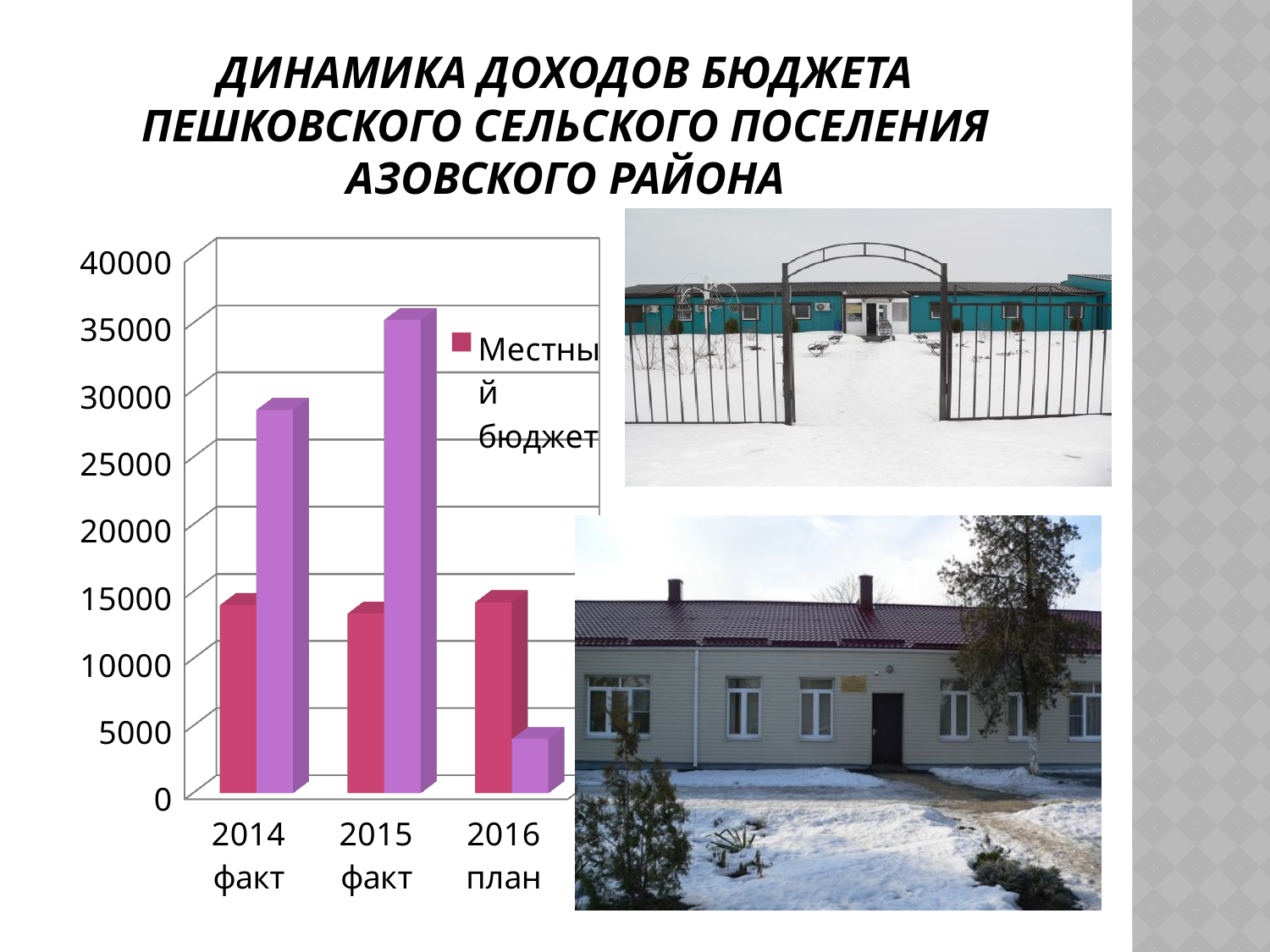
Is the value for Местный бюджет in 2016 план greater or less than 10000? greater Is the value of the purple bar for 2015 факт greater or less than 30000? greater Is the value for Местный бюджет in 2015 факт greater or less than 20000? less For which category is the purple bar the highest? 2015 факт Which series name is readable in the chart legend? Местный бюджет In 2016 план, which is larger: the Местный бюджет bar or the purple bar? Местный бюджет How many categories are shown on the x axis of the chart? 3 What kind of chart is shown on the slide? bar chart What are the category labels on the x axis of the chart? 2014 факт, 2015 факт, 2016 план